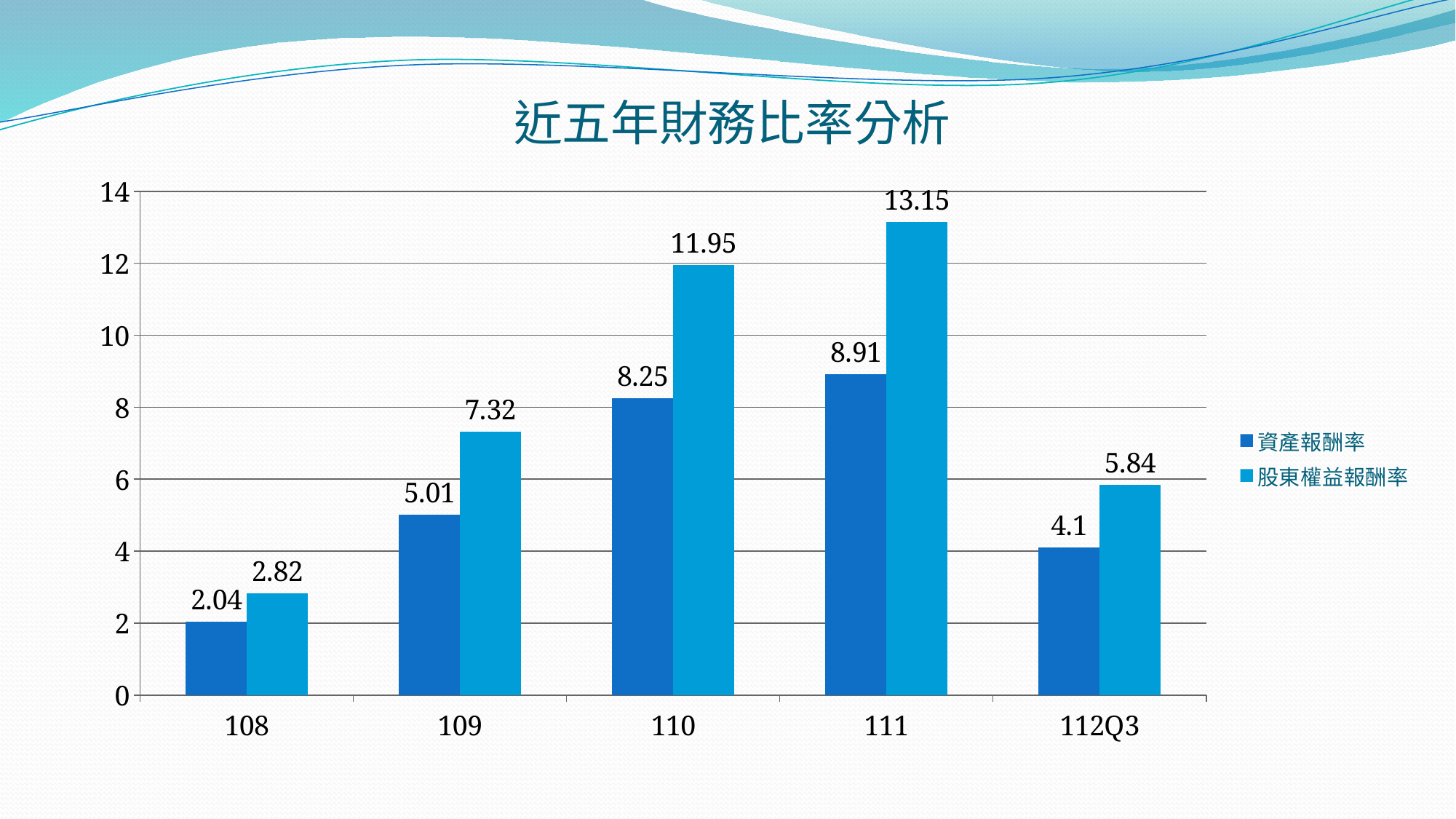
Is the value of 股東權益報酬率 for 110 greater or less than 10? greater Which category has the lowest 資產報酬率? 108 How many series does the legend list? 2 What is the value of 資產報酬率 for 110? 8.25 How many categories are shown on the x axis? 5 What is the value of 股東權益報酬率 for 112Q3? 5.84 What is the title of the chart? 近五年財務比率分析 Which is larger: 股東權益報酬率 for 109 or 資產報酬率 for 110? 資產報酬率 for 110 What is the value of 資產報酬率 for 108? 2.04 What is the difference between 股東權益報酬率 and 資產報酬率 for 111? 4.24 Which category has the highest 股東權益報酬率? 111 What kind of chart is shown on the slide? bar chart